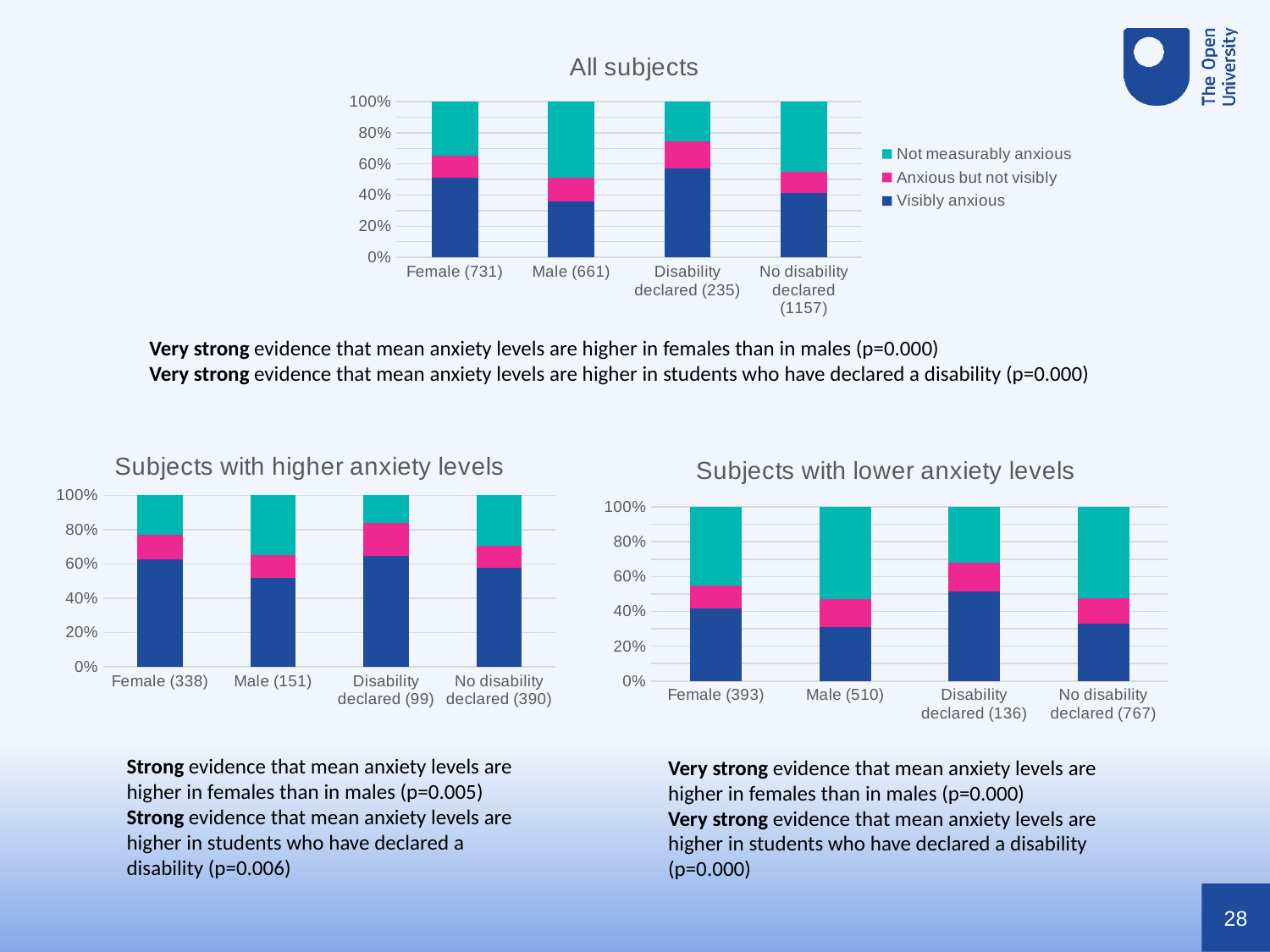
In the 'All subjects' chart, which category has the largest 'Visibly anxious' segment? Disability declared (235) In the 'Subjects with higher anxiety levels' chart, which has the larger 'Visibly anxious' segment, Female (338) or Male (151)? Female (338) In the 'Subjects with lower anxiety levels' chart, which category has the smallest 'Not measurably anxious' segment? Disability declared (136) In the 'All subjects' chart, is the 'Visibly anxious' value for Male (661) greater or less than 40%? less What is the title of the chart at the top of the slide? All subjects In the 'All subjects' chart, which category has the smallest 'Visibly anxious' segment? Male (661) How many categories are shown on the x axis of the 'Subjects with higher anxiety levels' chart? 4 How many charts are shown on the slide? 3 How many series does the legend of the 'All subjects' chart list? 3 What kind of chart is the 'All subjects' chart? Stacked bar chart In the 'All subjects' chart, is the 'Visibly anxious' value for Disability declared (235) greater or less than 50%? greater In the 'Subjects with lower anxiety levels' chart, is the 'Visibly anxious' value for Male (510) greater or less than 40%? less